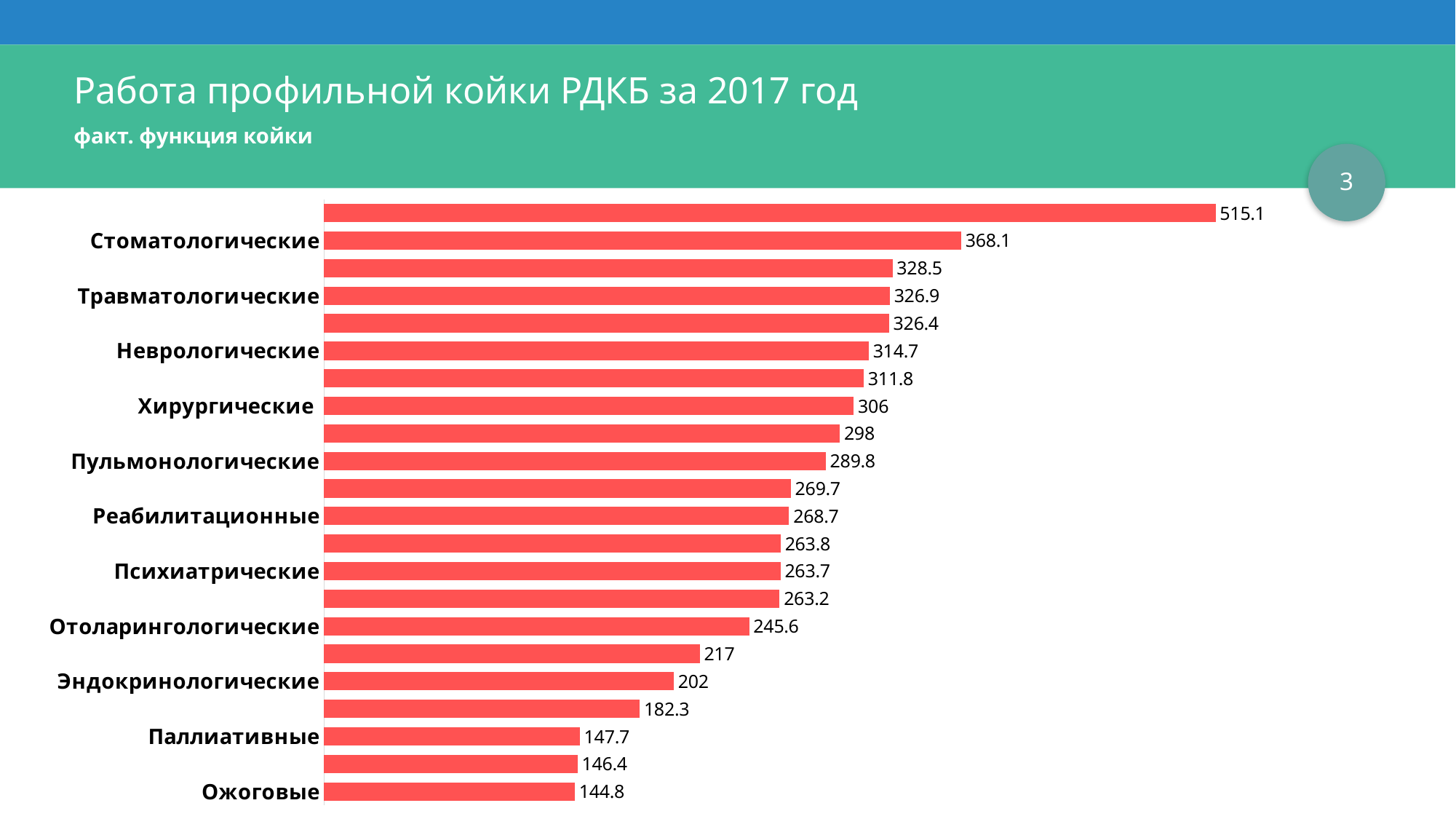
What is the title of the slide? Работа профильной койки РДКБ за 2017 год What is the value for Ожоговые? 144.8 What type of chart is shown on the slide? bar chart How many bars are plotted on the chart? 22 What is the value for Эндокринологические? 202 What is the value for Травматологические? 326.9 Which labeled category has the lowest value? Ожоговые What is the largest value shown on the chart? 515.1 What is the difference between the values for Стоматологические and Травматологические? 41.2 Which is larger, the value for Неврологические or the value for Пульмонологические? Неврологические What is the value for Хирургические? 306 What is the value for Стоматологические? 368.1